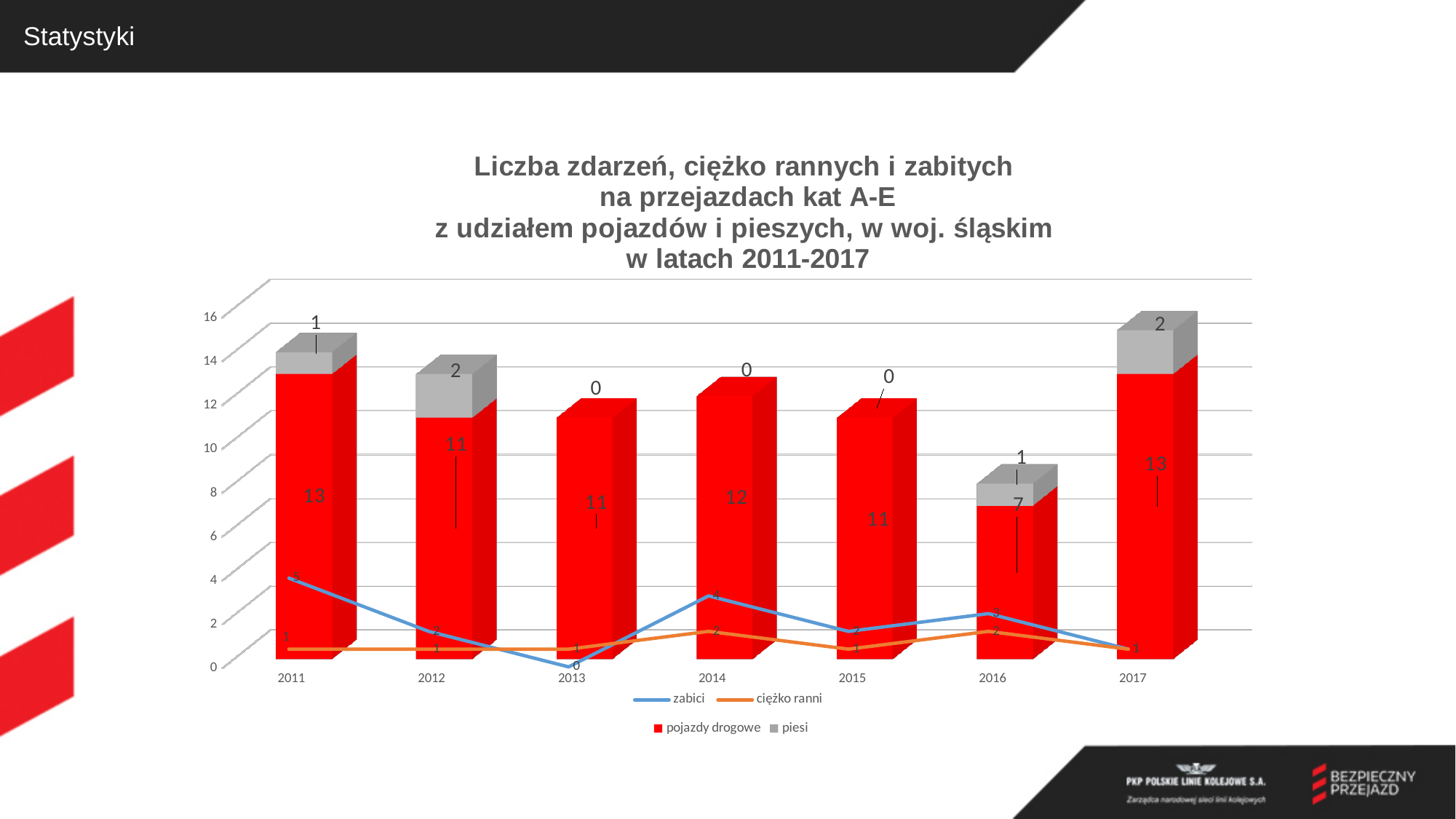
What is the value for piesi in 2012? 2 What is the difference between the pojazdy drogowe values for 2011 and 2016? 6 How many series does the legend list? 4 What is the total of the stacked bar for 2012 (pojazdy drogowe plus piesi)? 13 What is the total of the stacked bar for 2017 (pojazdy drogowe plus piesi)? 15 What is the value of the zabici line in 2013? 0 What is the value of the zabici line in 2014? 4 What is the value for pojazdy drogowe in 2016? 7 What is the value for pojazdy drogowe in 2014? 12 Which year has the larger piesi value, 2011 or 2017? 2017 Which year has the lowest value for pojazdy drogowe? 2016 How many years are shown on the x axis? 7